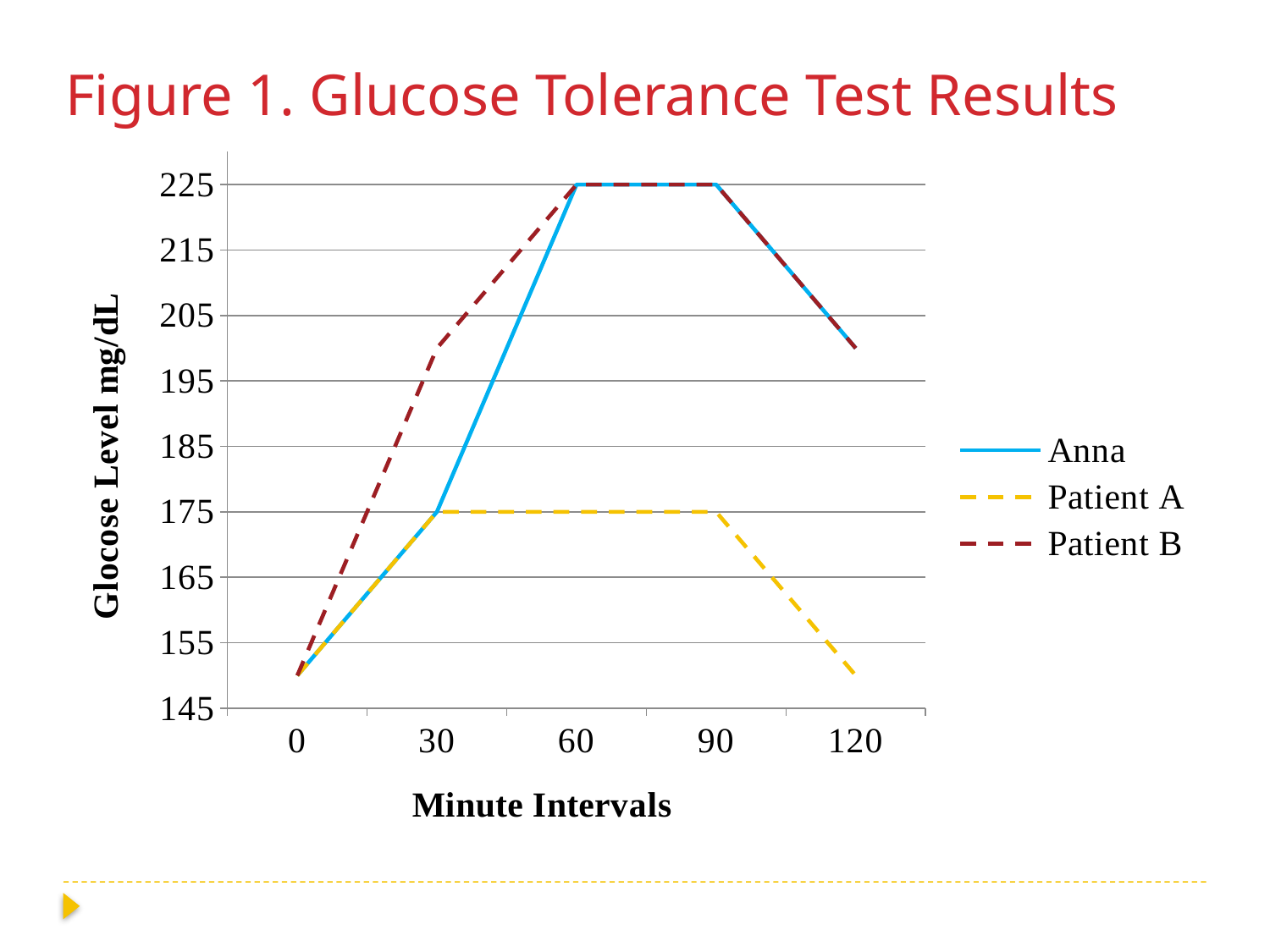
How many series does the legend list? 3 Is Patient A's glucose level at 120 minutes greater or less than 155? less What is Patient A's glucose level at 90 minutes? 175 At 30 minutes, which is higher: Patient B's glucose level or Anna's? Patient B What is the difference between Anna's glucose level at 60 minutes and at 30 minutes? 50 Is Patient B's glucose level at 30 minutes greater or less than 195? greater Is Anna's glucose level at 120 minutes greater or less than 195? greater What kind of chart is shown on the slide? line chart What is Anna's glucose level at 30 minutes? 175 What is Patient B's glucose level at 60 minutes? 225 What is Anna's glucose level at 60 minutes? 225 Which series has the lowest glucose level at 120 minutes? Patient A